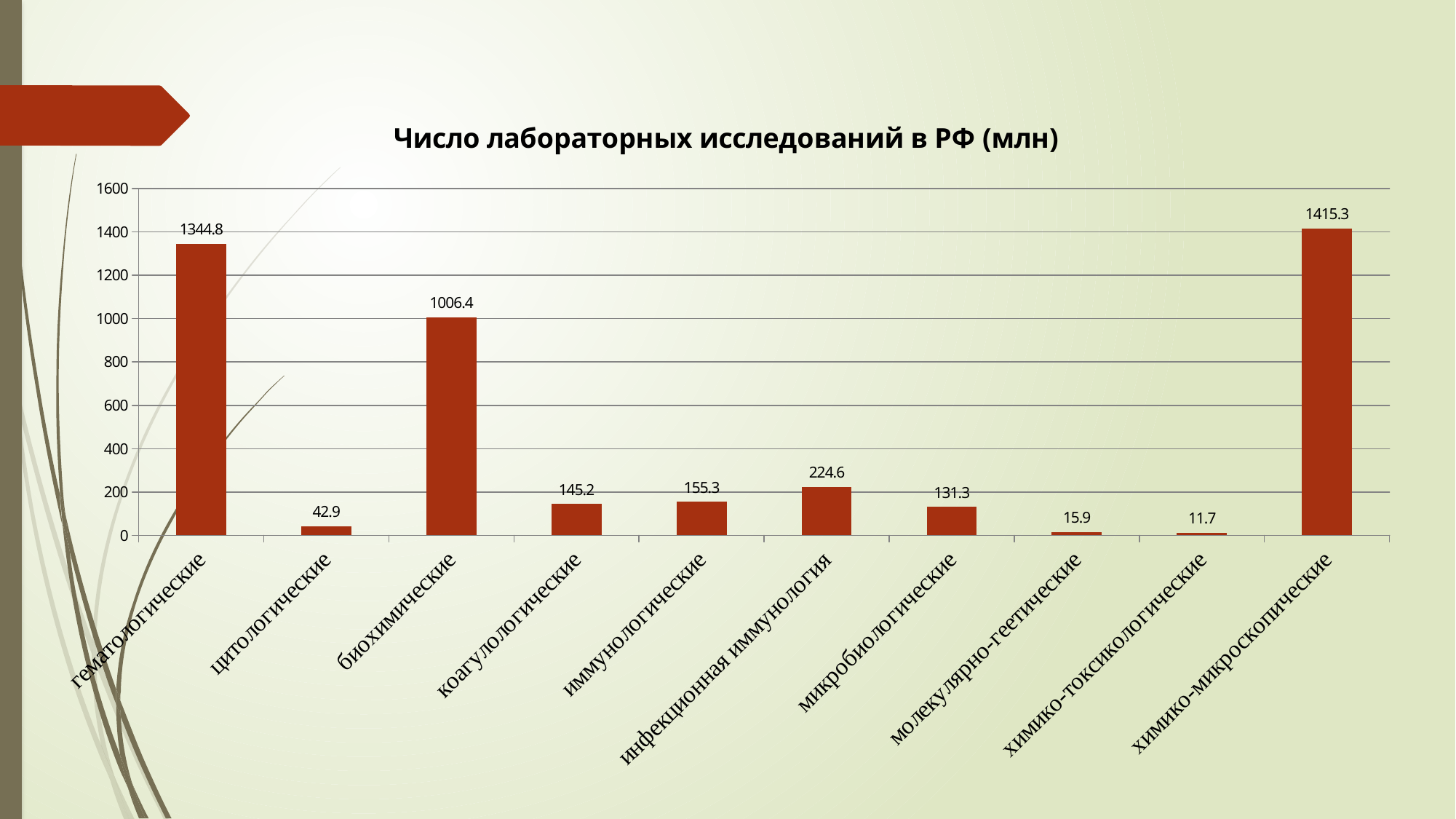
What is the value for гематологические? 1344.8 Is the value for биохимические greater or less than 1000? greater What is the title of the chart? Число лабораторных исследований в РФ (млн) What kind of chart is shown on the slide? bar chart What is the difference between the values for химико-микроскопические and гематологические? 70.5 What is the value for химико-токсикологические? 11.7 Which is larger, the value for иммунологические or the value for коагулологические? иммунологические How many categories are shown on the x axis? 10 What is the value for инфекционная иммунология? 224.6 Which category has the highest value? химико-микроскопические What is the difference between the values for биохимические and инфекционная иммунология? 781.8 Which category has the lowest value? химико-токсикологические